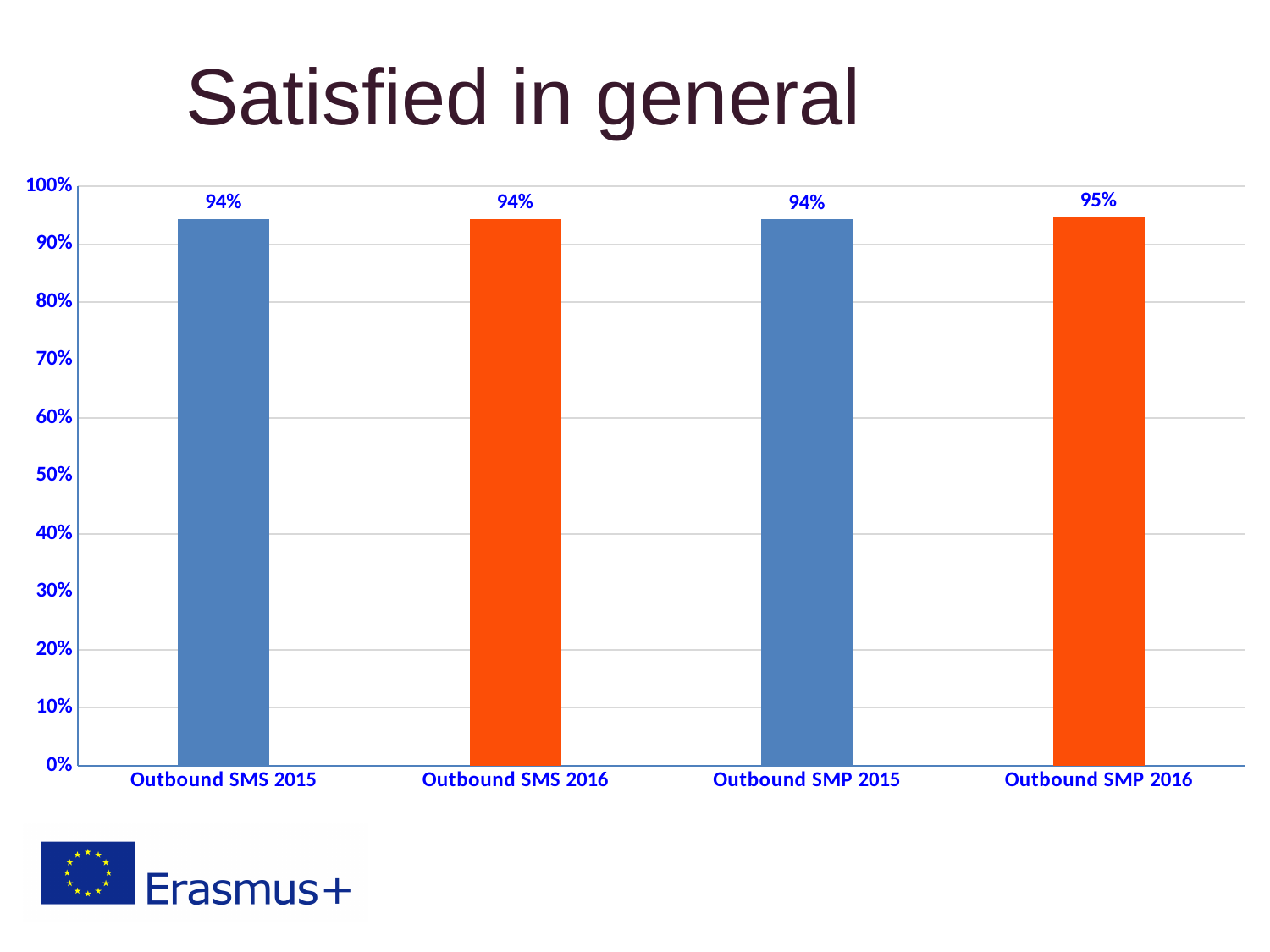
What is the title of the slide? Satisfied in general How many categories are shown on the x axis? 4 What is the value for Outbound SMP 2015? 94% What is the difference between the values for Outbound SMP 2016 and Outbound SMS 2016? 1% What is the value for Outbound SMP 2016? 95% What kind of chart is shown on the slide? bar chart Is the value for Outbound SMS 2016 greater or less than 90%? greater What is the highest value shown on the y axis? 100% What colour is the bar for Outbound SMS 2016? orange What is the value for Outbound SMS 2015? 94% Which category has the highest value? Outbound SMP 2016